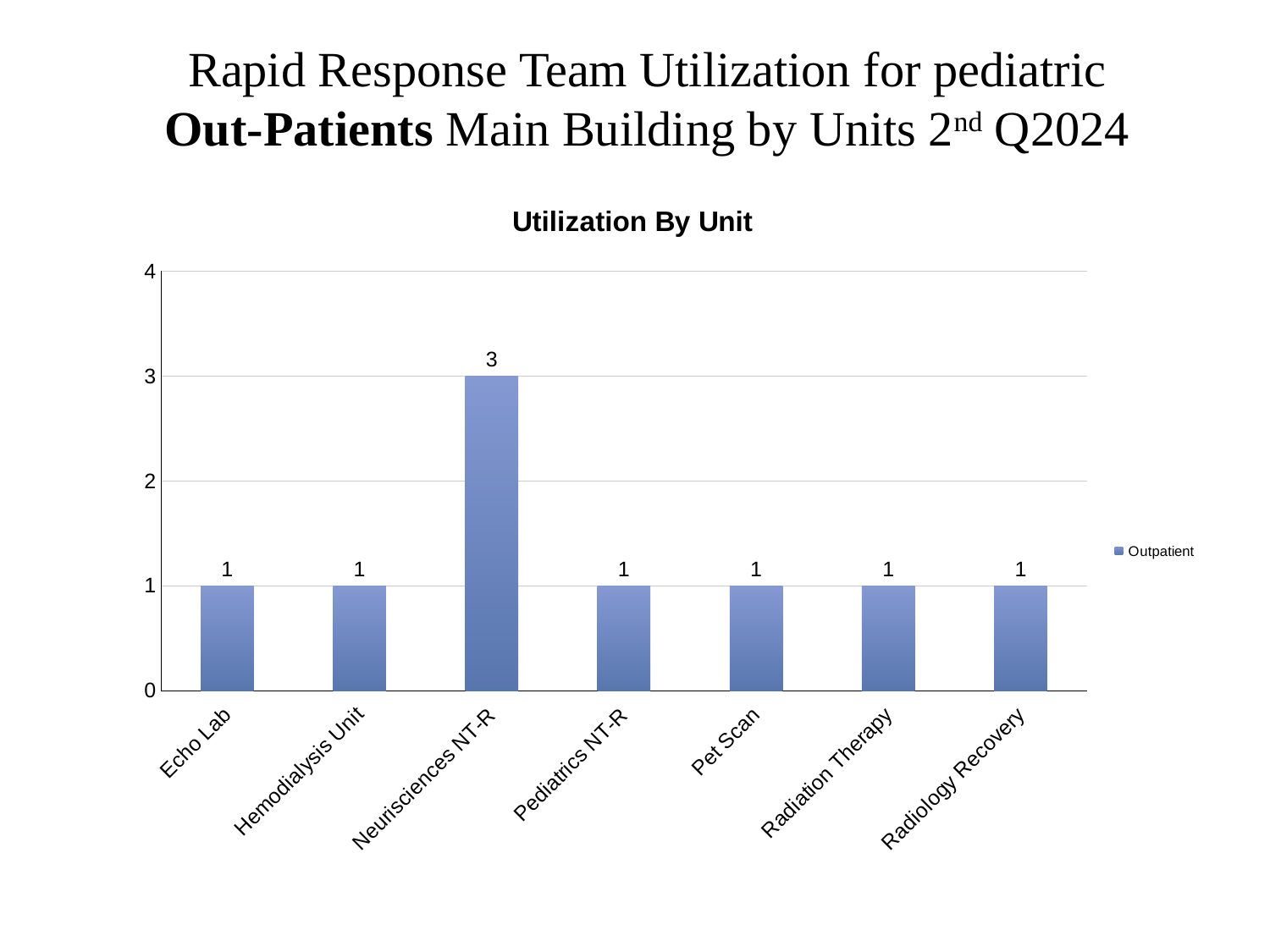
What is the Outpatient value for Echo Lab? 1 What is the difference between the Outpatient values for Neurisciences NT-R and Pet Scan? 2 Which unit has the highest Outpatient value? Neurisciences NT-R What is the Outpatient value for Neurisciences NT-R? 3 How many units are shown on the x axis? 7 Which has a larger Outpatient value, Neurisciences NT-R or Hemodialysis Unit? Neurisciences NT-R How many series does the legend list? 1 What is the Outpatient value for Radiation Therapy? 1 What kind of chart is shown? bar chart Is the value for Neurisciences NT-R greater or less than 2? greater What series name is shown in the legend? Outpatient What is the title of the chart? Utilization By Unit